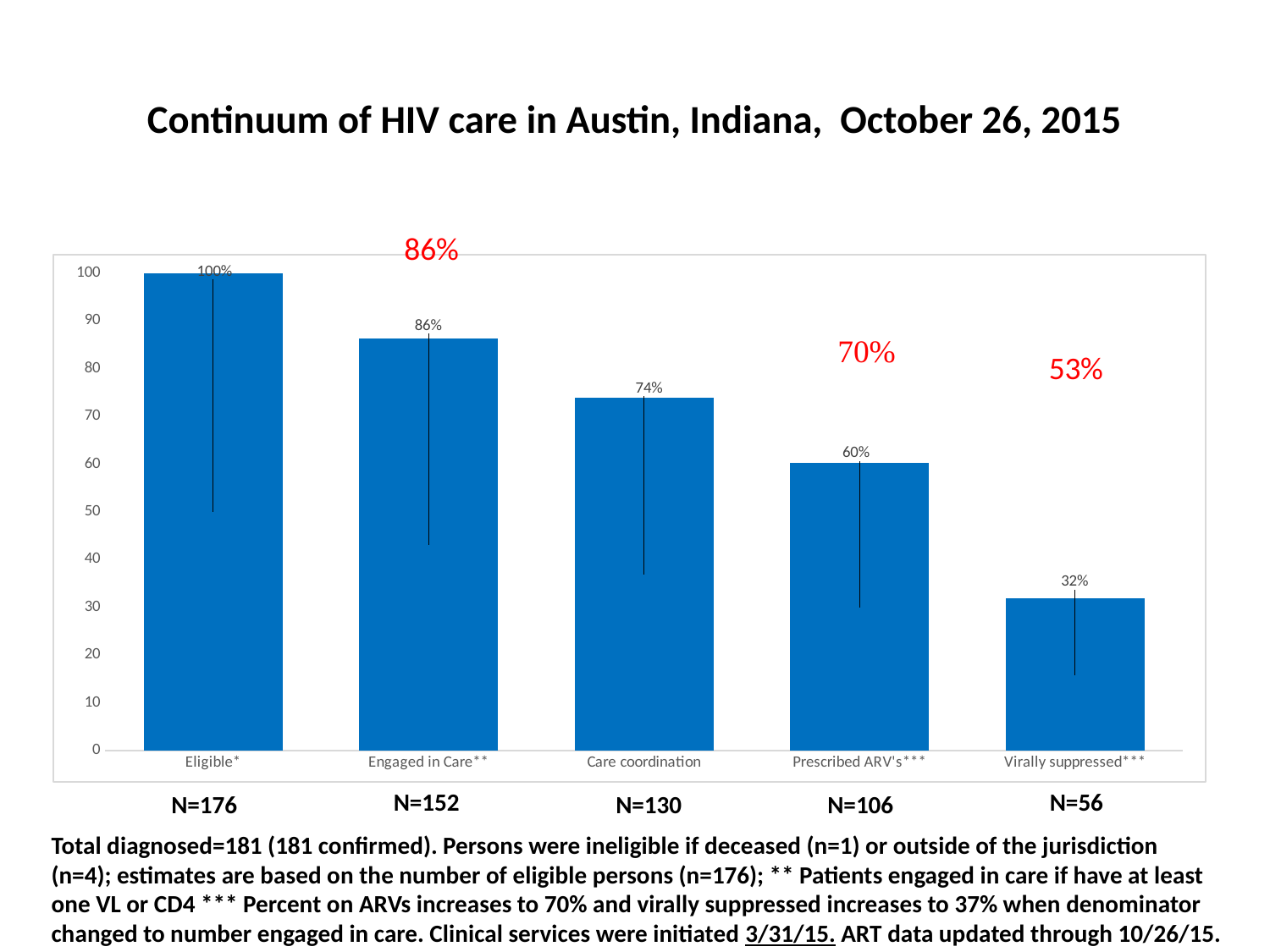
How many categories are plotted in the chart? 5 What kind of chart is shown on the slide? bar chart Do the values rise or fall from left to right across the categories? fall What is the value for Prescribed ARV's***? 60% Which category has the highest value? Eligible* What is the difference between the values for Engaged in Care** and Care coordination? 12% What is the value for Virally suppressed***? 32% What is the value for Engaged in Care**? 86% Which category has the lowest value? Virally suppressed*** What is the value for Care coordination? 74% What is the title of the chart? Continuum of HIV care in Austin, Indiana, October 26, 2015 Which is larger, the value for Prescribed ARV's*** or the value for Virally suppressed***? Prescribed ARV's***